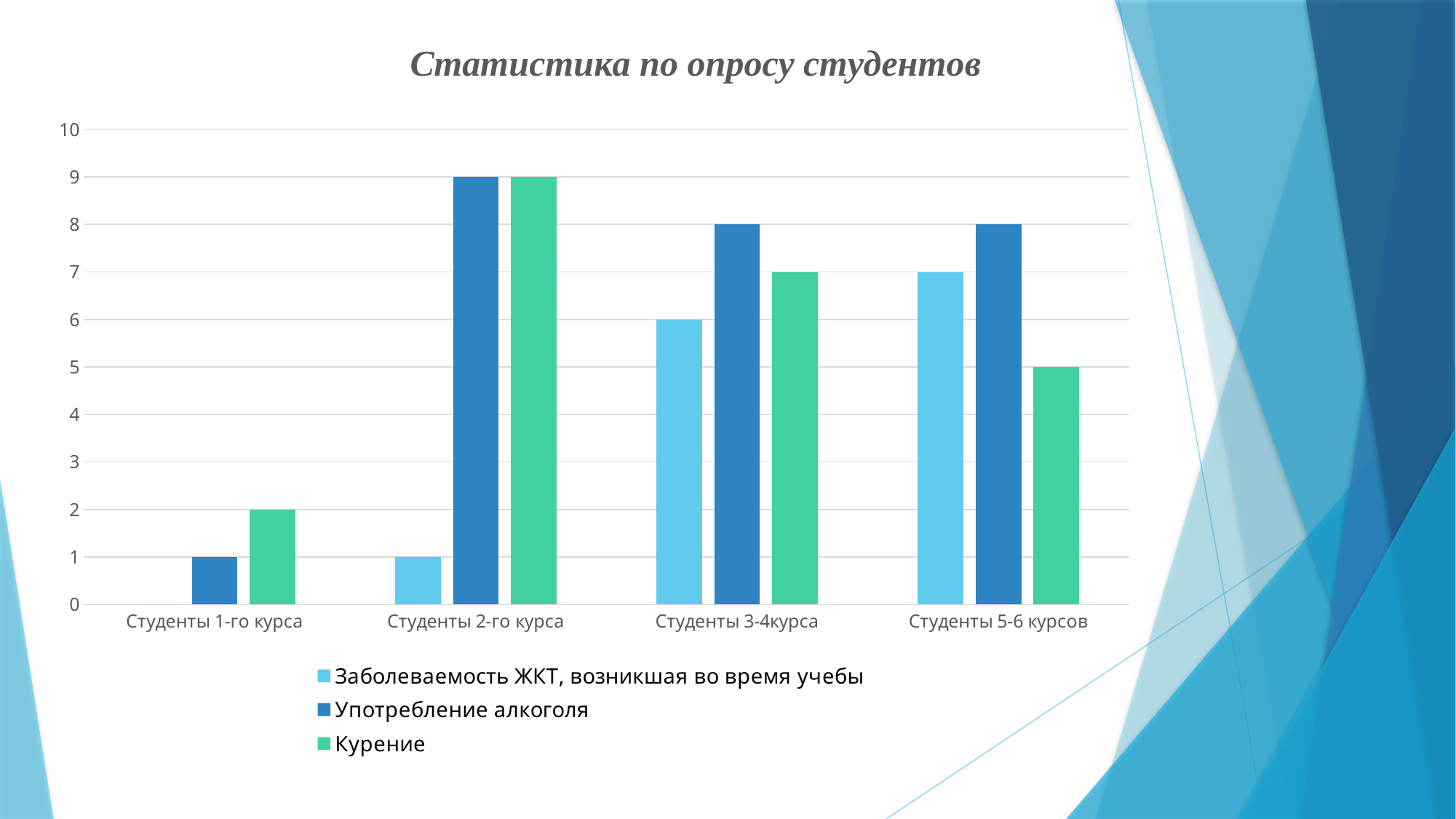
How many student groups (categories) are shown on the x axis? 4 What is the title of the chart? Статистика по опросу студентов What is the value of Курение for Студенты 5-6 курсов? 5 What type of chart is shown on the slide? Bar chart What is the value of Заболеваемость ЖКТ, возникшая во время учебы for Студенты 3-4курса? 6 For Студенты 3-4курса, which is larger: Употребление алкоголя or Курение? Употребление алкоголя What is the value of Употребление алкоголя for Студенты 2-го курса? 9 Which student group has the lowest value for Курение? Студенты 1-го курса How many series does the legend list? 3 Does the value of Курение rise or fall from Студенты 2-го курса to Студенты 5-6 курсов? Fall Which student group has the highest value for Заболеваемость ЖКТ, возникшая во время учебы? Студенты 5-6 курсов What is the difference between Употребление алкоголя and Курение for Студенты 5-6 курсов? 3